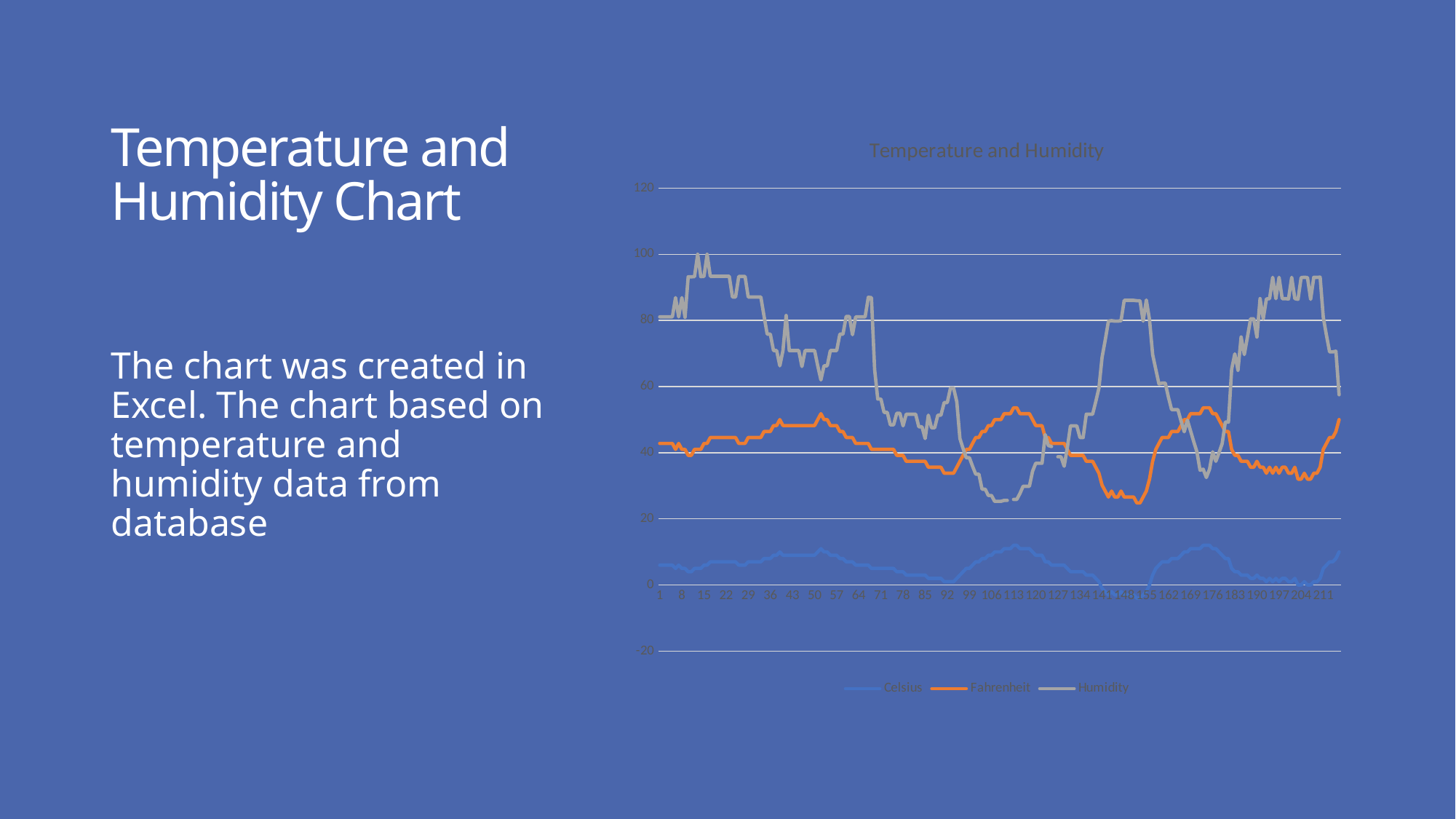
At x = 106, which series has the larger value, Fahrenheit or Humidity? Fahrenheit Is the Humidity value at x = 148 greater or less than 80? greater Is the Humidity value at x = 106 greater or less than 40? less What is the title of the chart? Temperature and Humidity Which series reaches the highest value on the chart? Humidity What are the three series named in the chart's legend? Celsius, Fahrenheit, Humidity Does the Humidity line rise or fall between x = 64 and x = 106? fall Is the Celsius value at x = 113 greater or less than 20? less At x = 15, which series has the larger value, Humidity or Fahrenheit? Humidity What kind of chart is shown on the slide? line chart How many series does the chart's legend list? 3